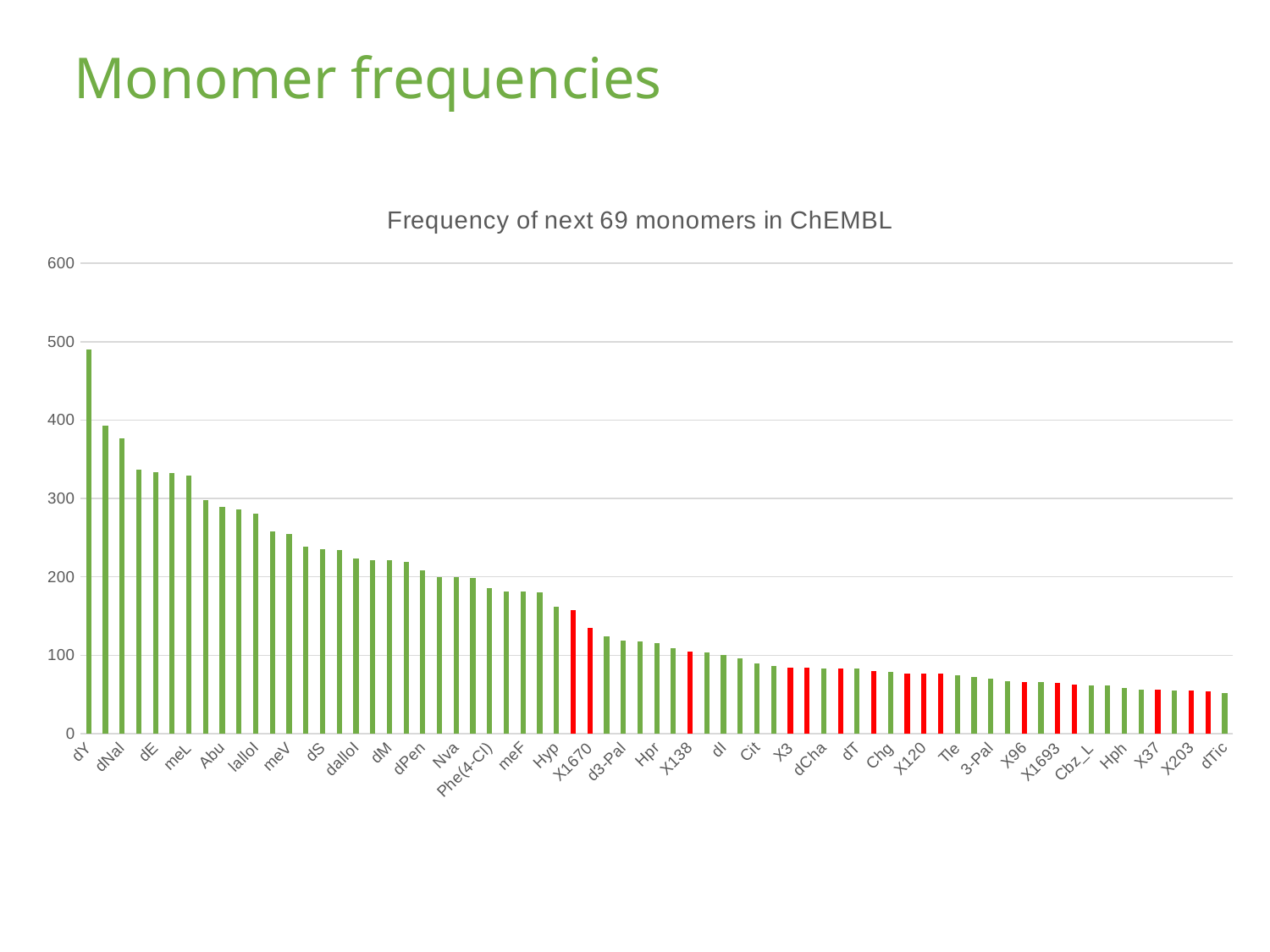
What is the title of the chart? Frequency of next 69 monomers in ChEMBL Is the value for dNal greater or less than 300? greater Is the value for dTic greater or less than 100? less How many monomers does the chart title say are plotted? 69 What kind of chart is shown on the slide? bar chart Which monomer has the highest frequency in the chart? dY What two colours are used for the bars in the chart? green and red Is the value for Hyp greater or less than 200? less Do the bar values rise or fall moving from left to right along the x axis? fall Which has a higher frequency, dE or Hyp? dE